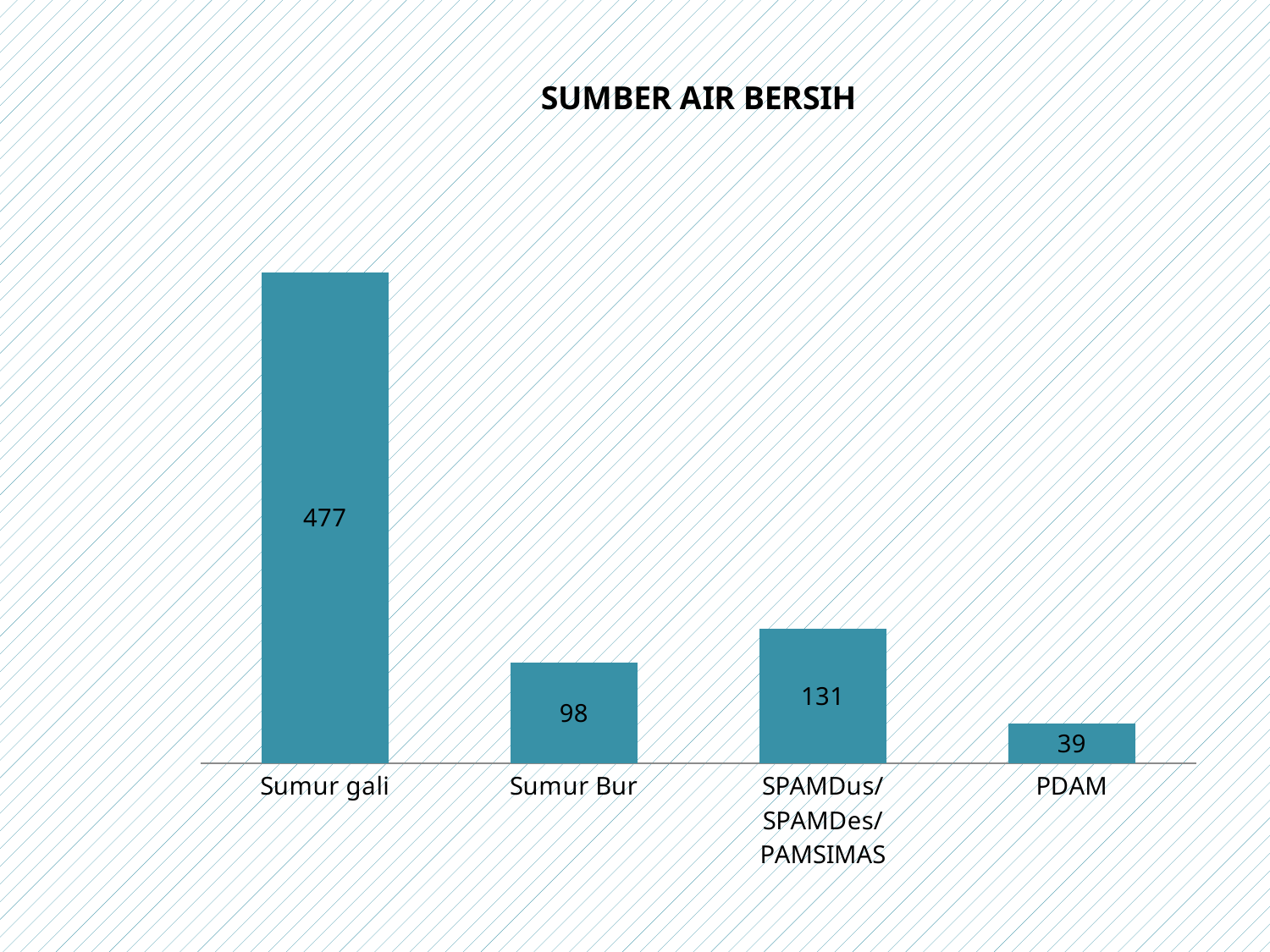
What is the difference between the values for SPAMDus/SPAMDes/PAMSIMAS and PDAM? 92 How many categories are shown in the chart? 4 What kind of chart is shown on the slide? Bar chart What is the value for SPAMDus/SPAMDes/PAMSIMAS? 131 Which category has the highest value? Sumur gali What is the value for Sumur gali? 477 What is the title of the chart? SUMBER AIR BERSIH Which category has the lowest value? PDAM What is the difference between the values for Sumur gali and Sumur Bur? 379 What is the value for PDAM? 39 What is the value for Sumur Bur? 98 Which is larger, the value for Sumur Bur or the value for SPAMDus/SPAMDes/PAMSIMAS? SPAMDus/SPAMDes/PAMSIMAS